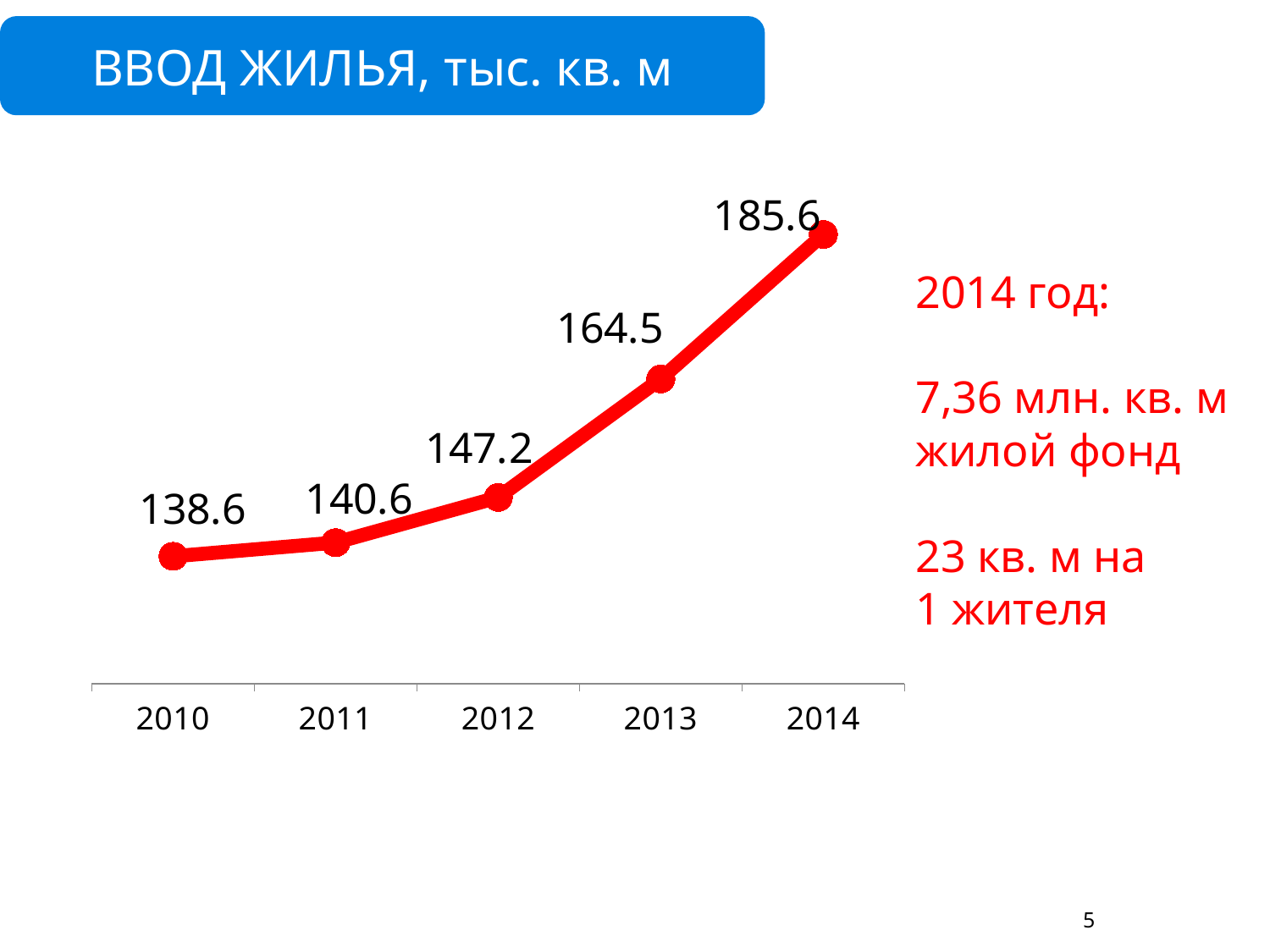
Which year has the lowest value? 2010 Which is larger, the value for 2012 or the value for 2013? 2013 How many years are plotted on the chart? 5 What is the value for 2012? 147.2 Which year has the highest value? 2014 What is the value for 2014? 185.6 What is the difference between the values for 2011 and 2010? 2.0 What kind of chart is shown on the slide? line chart What is the title of the chart? ВВОД ЖИЛЬЯ, тыс. кв. м Do the values rise or fall from 2010 to 2014? rise What is the value for 2010? 138.6 What is the difference between the values for 2014 and 2013? 21.1